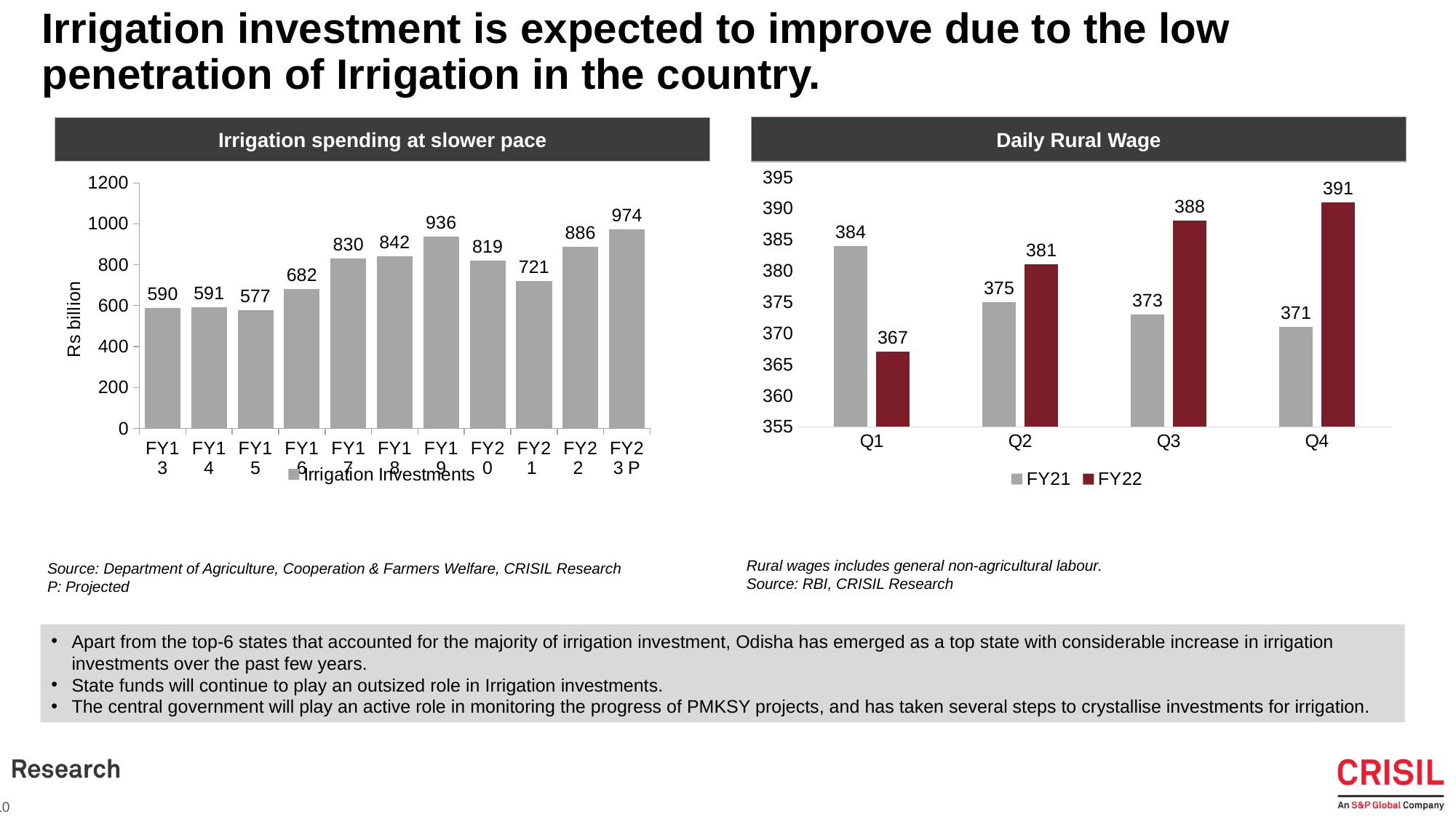
In the 'Irrigation spending at slower pace' chart, what is the difference between the FY23 P value and the FY22 value? 88 In the 'Irrigation spending at slower pace' chart, what unit is shown on the y axis? Rs billion In the 'Irrigation spending at slower pace' chart, which year has the lowest irrigation investment? FY15 In the 'Daily Rural Wage' chart, do the FY22 values rise or fall from Q1 to Q4? rise In the 'Daily Rural Wage' chart, what is the FY21 value for Q1? 384 In the 'Irrigation spending at slower pace' chart, which year has the highest irrigation investment? FY23 P In the 'Daily Rural Wage' chart, which is larger for Q1: FY21 or FY22? FY21 In the 'Irrigation spending at slower pace' chart, how many years are shown on the x axis? 11 In the 'Irrigation spending at slower pace' chart, what is the value for FY19? 936 In the 'Daily Rural Wage' chart, how many series does the legend list? 2 In the 'Daily Rural Wage' chart, what is the FY22 value for Q3? 388 In the 'Daily Rural Wage' chart, what is the difference between the FY22 and FY21 values for Q4? 20